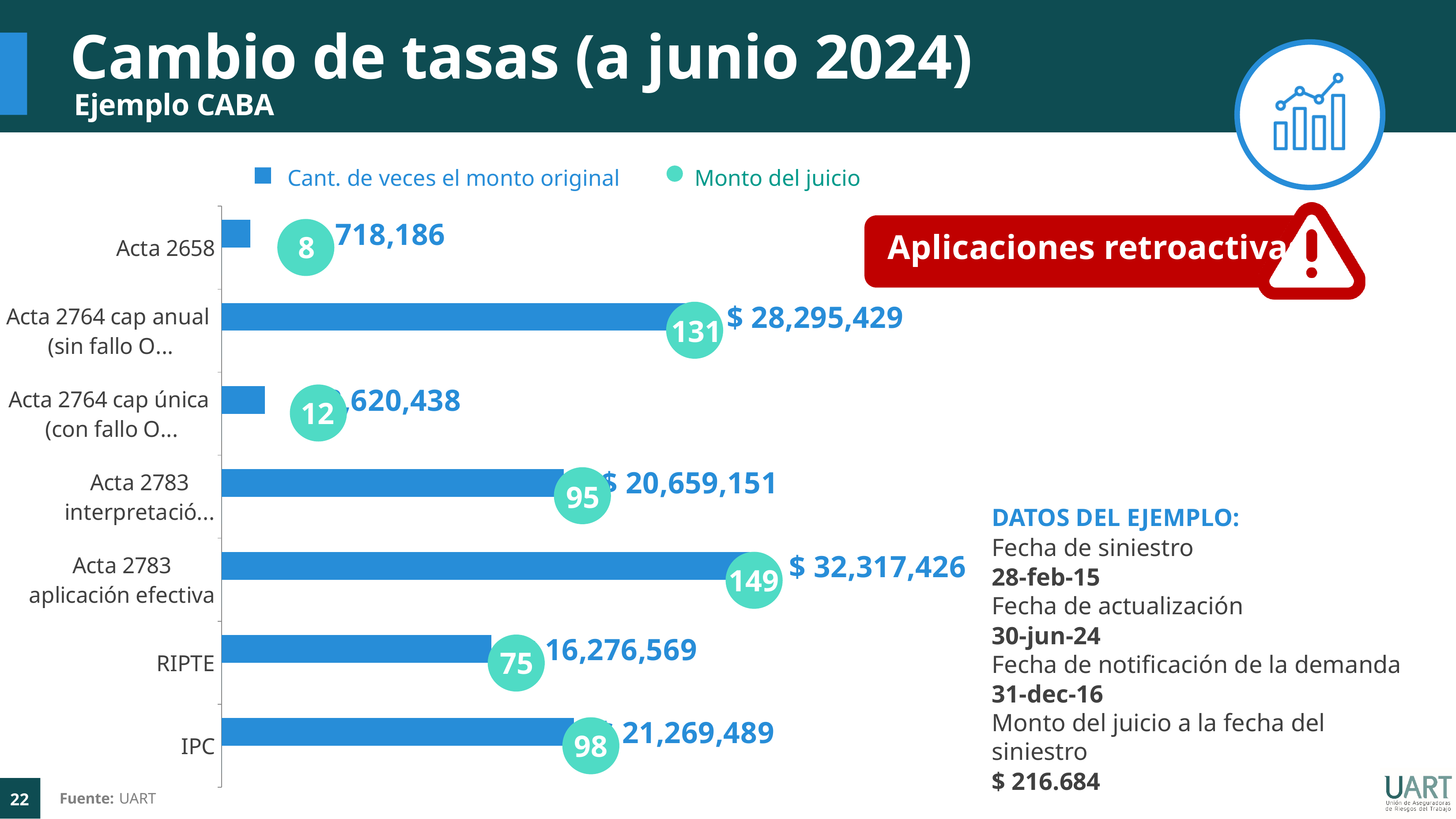
What is the 'Monto del juicio' for Acta 2764 cap anual (sin fallo O...)? $ 28,295,429 What kind of chart is shown on the slide? bar chart How many categories are plotted on the chart? 7 Which category has the highest 'Cant. de veces el monto original'? Acta 2783 aplicación efectiva Which category has the lowest 'Cant. de veces el monto original'? Acta 2658 What is the difference in 'Cant. de veces el monto original' between Acta 2783 aplicación efectiva and Acta 2764 cap anual (sin fallo O...)? 18 What are the two legend entries of the chart? Cant. de veces el monto original; Monto del juicio What is the 'Cant. de veces el monto original' value for Acta 2783 aplicación efectiva? 149 Which has a larger 'Cant. de veces el monto original', RIPTE or IPC? IPC What is the 'Monto del juicio' for Acta 2783 interpretació...? $ 20,659,151 How many series does the chart legend list? 2 What is the 'Cant. de veces el monto original' value for RIPTE? 75